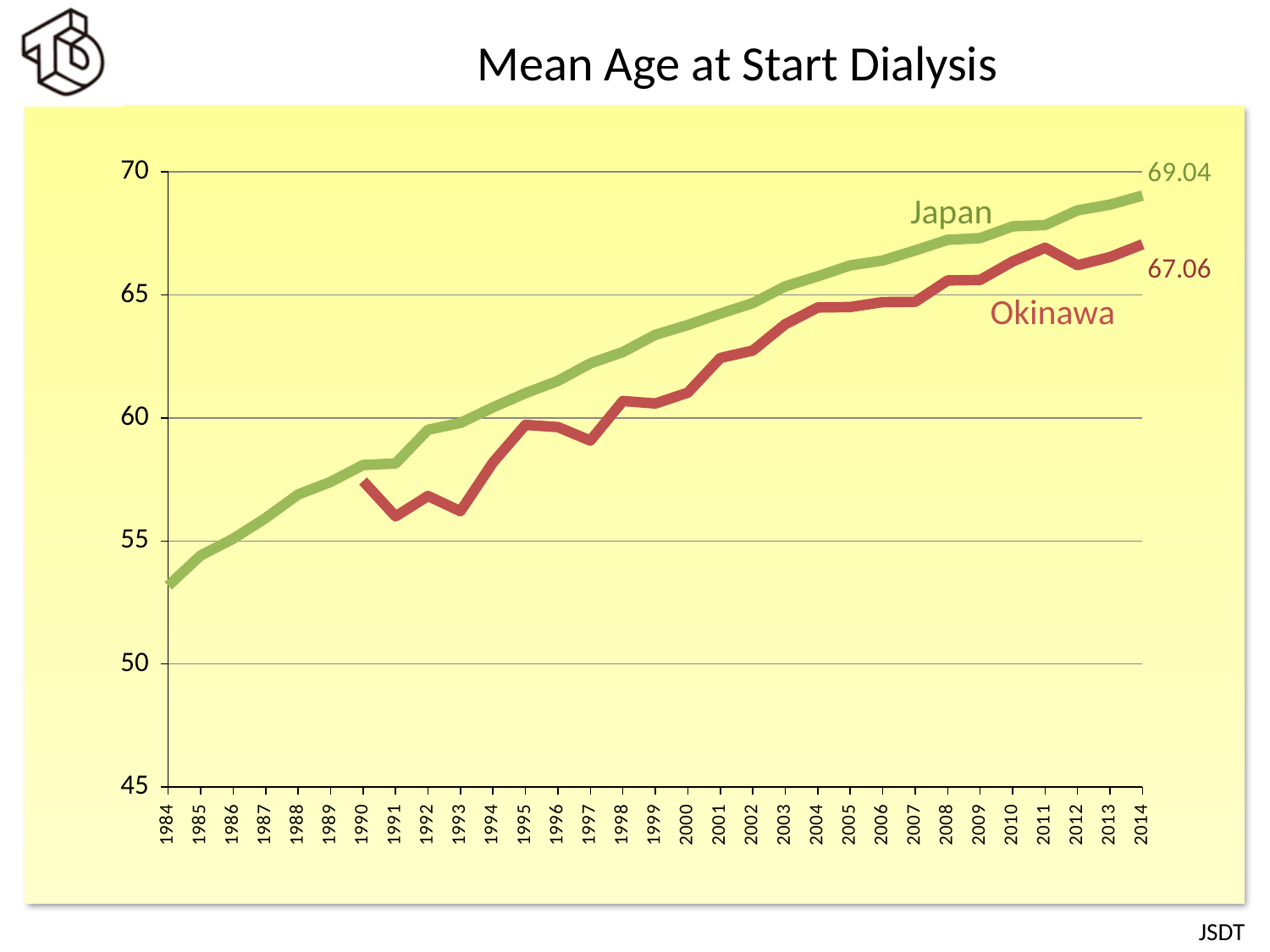
How many series are plotted on the chart? 2 Is the value for Japan in 2000 greater or less than 60? greater What kind of chart is shown on the slide? line chart Is the value for Okinawa in 1993 greater or less than 60? less Is the value for Japan in 1984 greater or less than 55? less Which series has the higher value in 2014, Japan or Okinawa? Japan What is the value for Okinawa in 2014? 67.06 How many years are shown on the x axis? 31 What is the title of the chart? Mean Age at Start Dialysis What is the difference between the Japan and Okinawa values in 2014? 1.98 Do the values for Japan rise or fall from 1984 to 2014? rise What is the value for Japan in 2014? 69.04